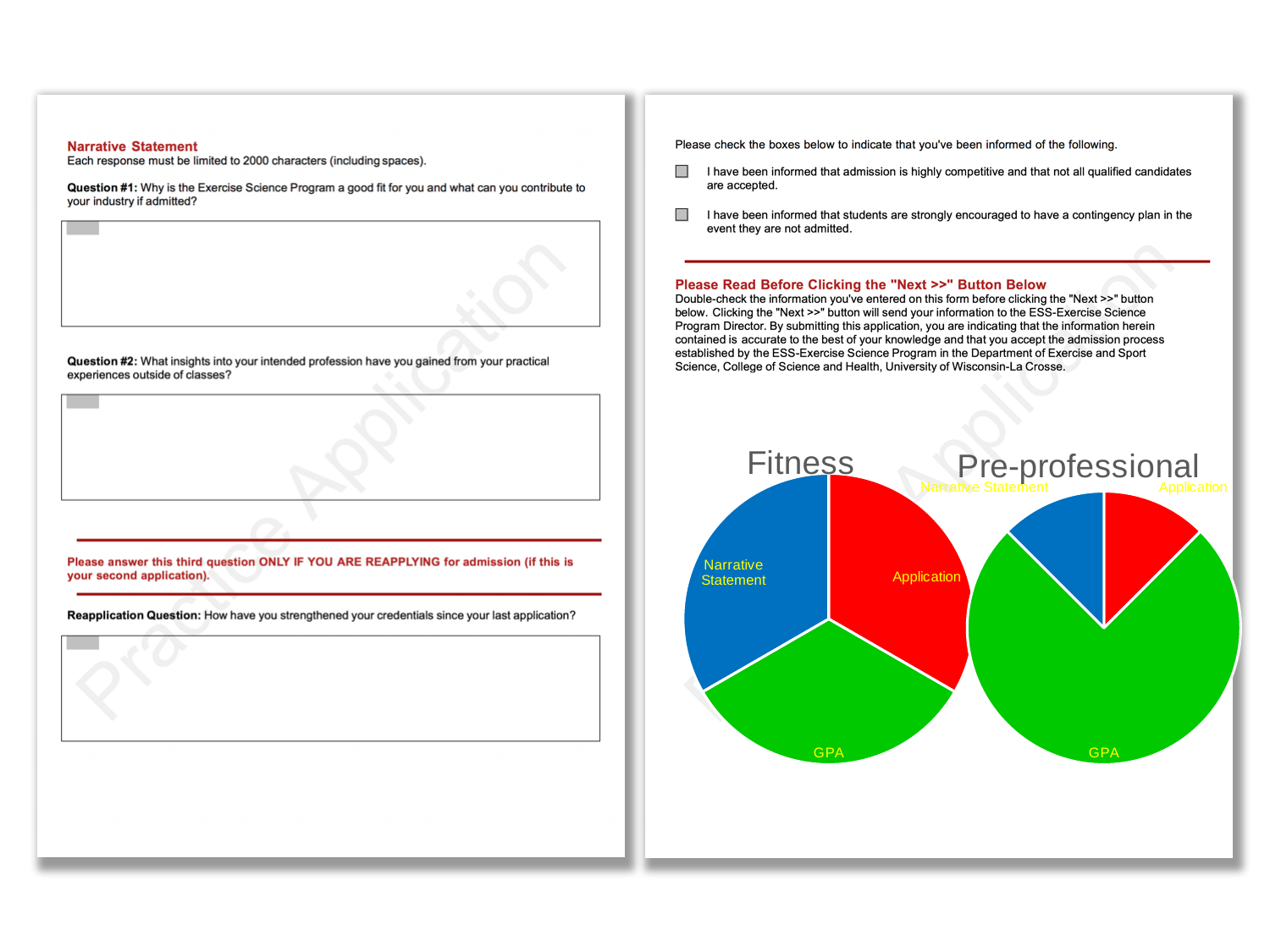
How many pie charts are shown on the slide? 2 In the Pre-professional chart, which slice is the largest? GPA In the Pre-professional chart, which is larger, the GPA slice or the Narrative Statement slice? GPA In which of the two pie charts does GPA take up a larger share, Fitness or Pre-professional? Pre-professional What colour is the GPA slice in the Fitness pie chart? green How many slices does the Pre-professional pie chart have? 3 What are the titles of the two pie charts on the slide? Fitness and Pre-professional In the Pre-professional chart, which is larger, the GPA slice or the Application slice? GPA How many slices does the Fitness pie chart have? 3 What kind of chart is the Pre-professional chart? pie chart What kind of chart is the Fitness chart? pie chart